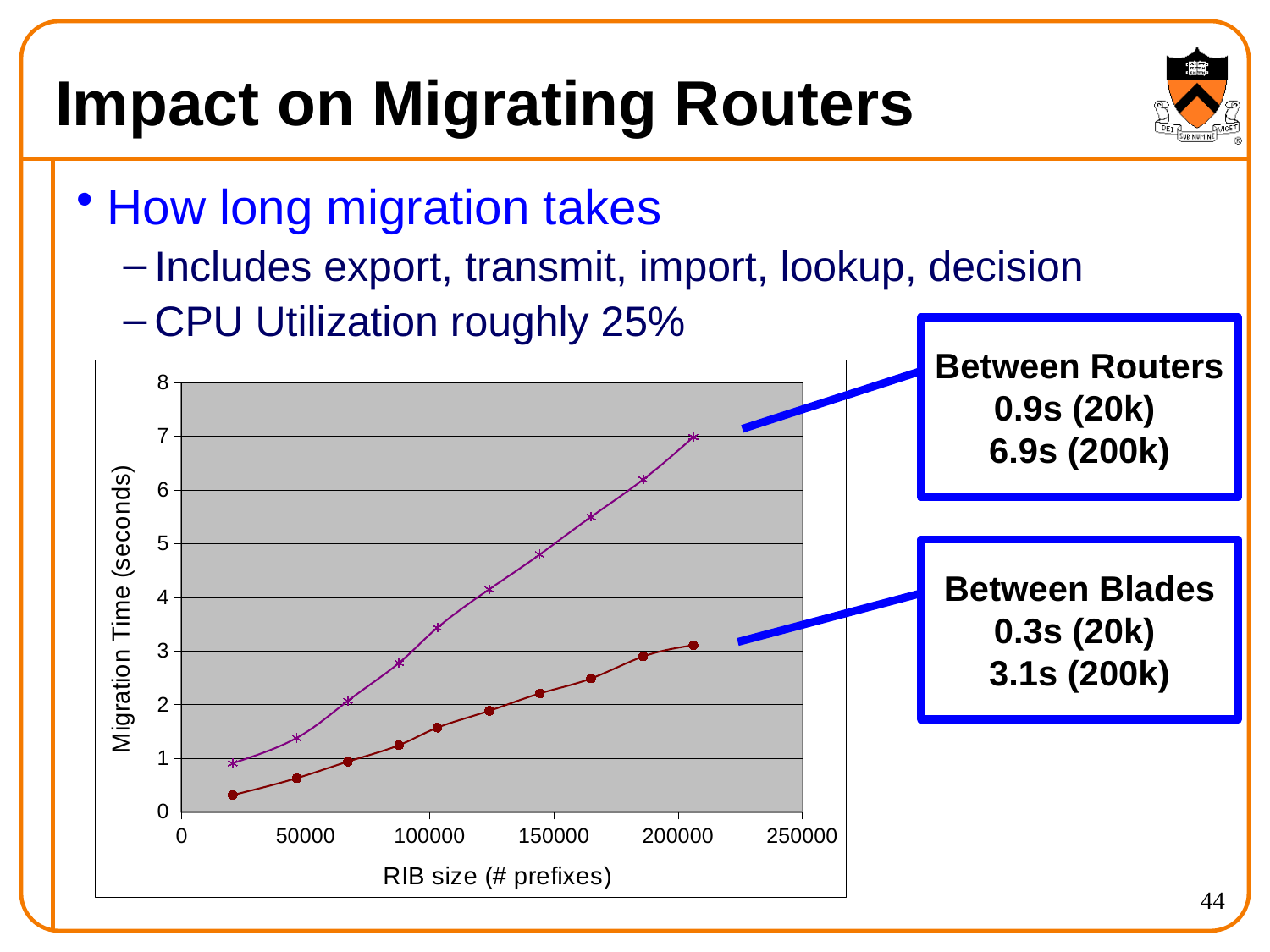
At 20k prefixes, which takes longer: migration between routers or between blades? Between Routers How many data series (lines) are plotted on the chart? 2 What is the migration time between routers for a RIB size of 200k prefixes? 6.9s How does migration time change as RIB size increases along the x axis? It rises Is the migration time between blades at a RIB size of 150000 greater or less than 3 seconds? less What is the migration time between blades for a RIB size of 200k prefixes? 3.1s What is the migration time between blades for a RIB size of 20k prefixes? 0.3s What is the migration time between routers for a RIB size of 20k prefixes? 0.9s What kind of chart is shown on the slide? line chart Is the migration time between routers at a RIB size of 150000 greater or less than 4 seconds? greater At 200k prefixes, how much longer does migration between routers take than migration between blades? 3.8s What is the label of the y axis of the chart? Migration Time (seconds)